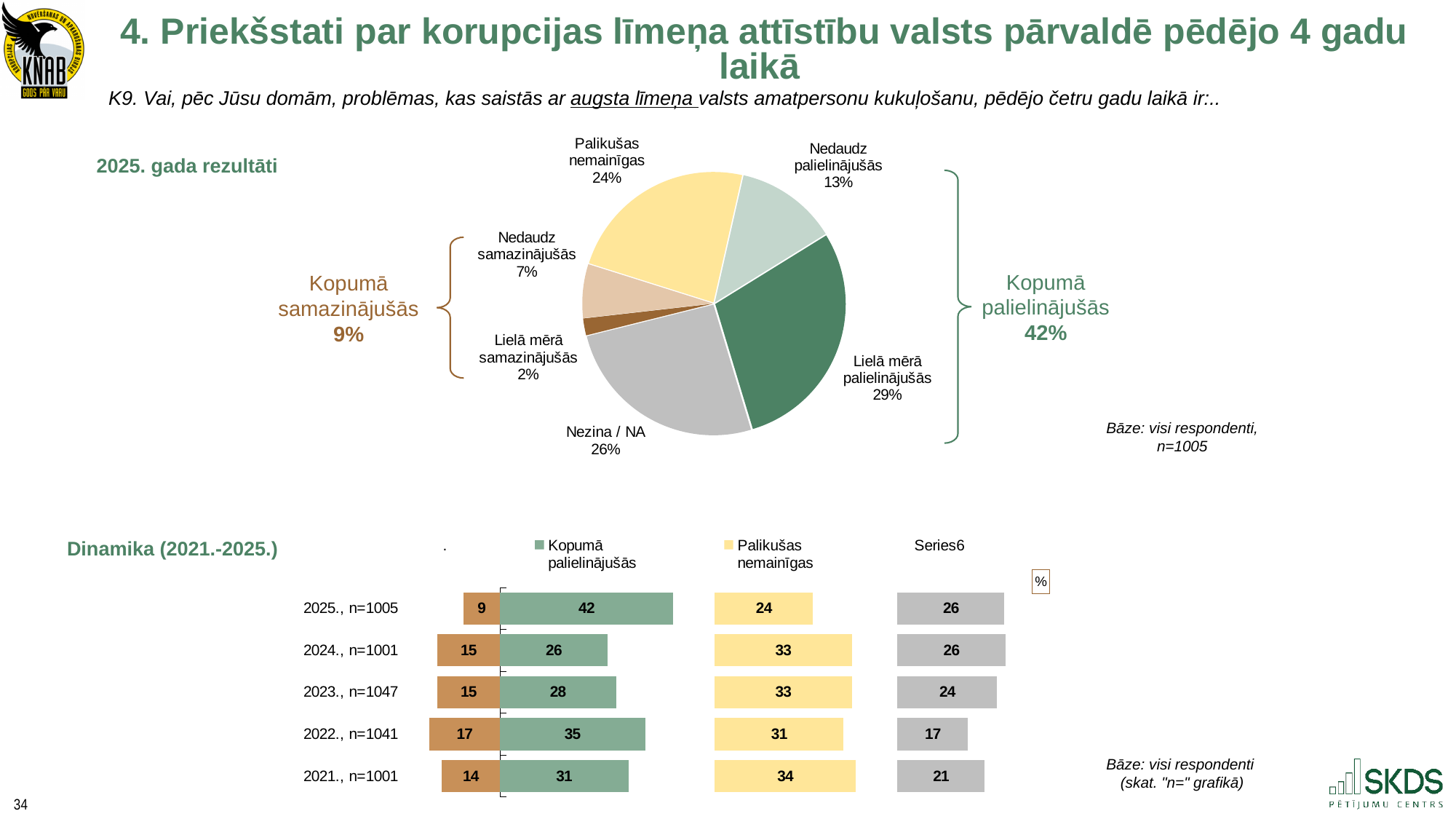
In the Dinamika (2021.-2025.) chart, what is the value of "Kopumā palielinājušās" for 2025., n=1005? 42 In the Dinamika (2021.-2025.) chart, what is the value of "Palikušas nemainīgas" for 2021., n=1001? 34 In the pie chart (2025. gada rezultāti), what share is shown for "Lielā mērā palielinājušās"? 29% In the Dinamika (2021.-2025.) chart, which year has the lowest value for "Kopumā palielinājušās"? 2024., n=1001 What type of chart is the Dinamika (2021.-2025.) chart? Bar chart In the pie chart (2025. gada rezultāti), which category has the smallest slice? Lielā mērā samazinājušās In the pie chart (2025. gada rezultāti), which category has the largest slice? Lielā mērā palielinājušās In the pie chart (2025. gada rezultāti), what percentage of respondents answered "Nezina / NA"? 26% In the pie chart (2025. gada rezultāti), what is the difference between "Palikušas nemainīgas" and "Nedaudz palielinājušās"? 11% In the Dinamika (2021.-2025.) chart, is the "Palikušas nemainīgas" value larger for 2024., n=1001 or for 2025., n=1005? 2024., n=1001 In the pie chart (2025. gada rezultāti), how many slices does the pie have? 6 In the pie chart (2025. gada rezultāti), what is the combined share labelled "Kopumā palielinājušās"? 42%